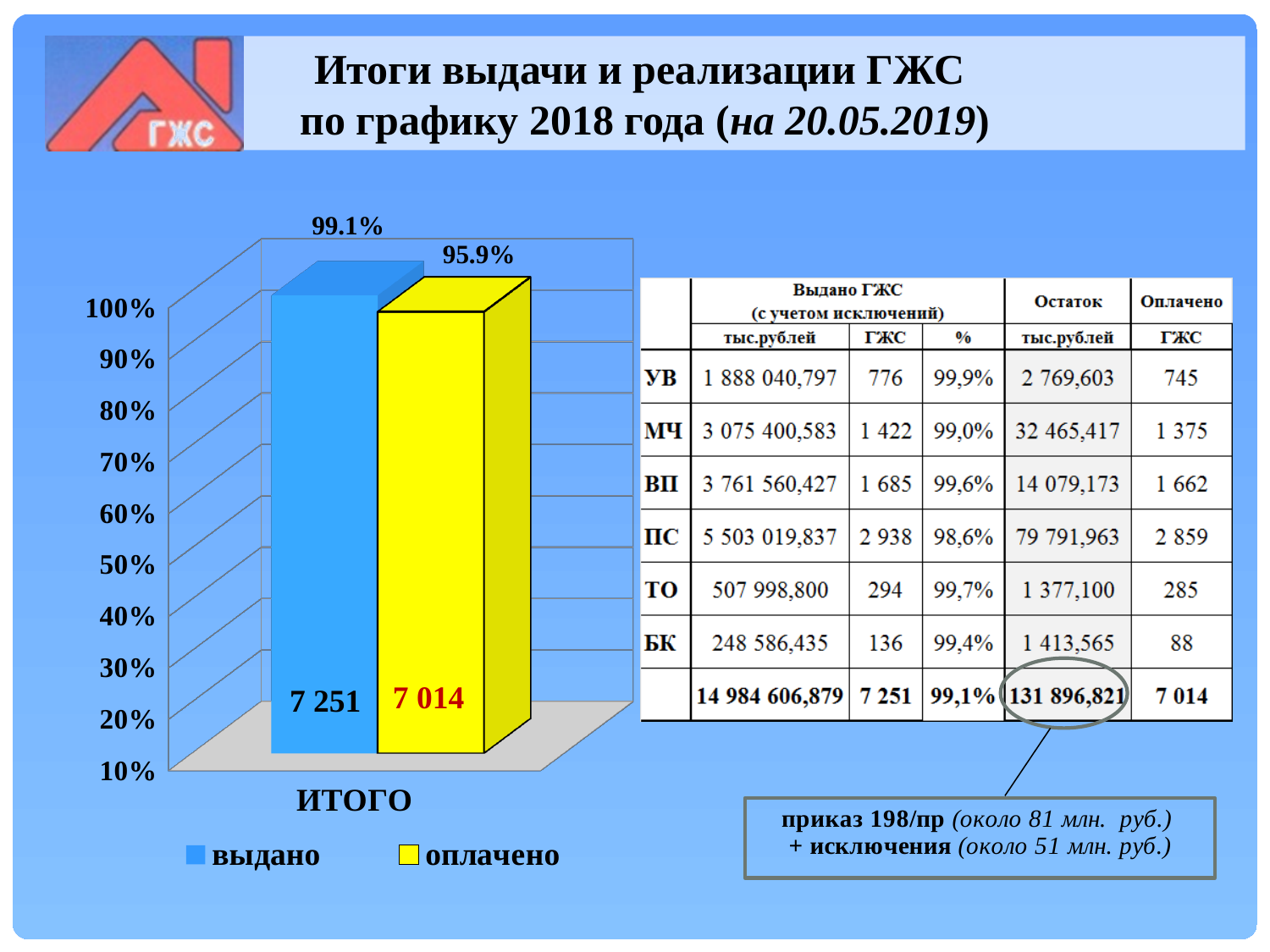
What is the difference between the numbers printed in the bars, 7 251 and 7 014? 237 What is the category label shown on the x axis of the chart? ИТОГО Which series has the higher percentage, 'выдано' or 'оплачено'? выдано What number is printed inside the 'оплачено' bar? 7 014 Is the value for 'оплачено' greater or less than 90%? greater What percentage is labelled above the 'выдано' bar? 99.1% How many series does the chart legend list? 2 How many categories are shown on the x axis of the chart? 1 What kind of chart is shown on the left of the slide? bar chart What percentage is labelled above the 'оплачено' bar? 95.9% What number is printed inside the 'выдано' bar? 7 251 What is the difference in percentage points between the 'выдано' bar (99.1%) and the 'оплачено' bar (95.9%)? 3.2